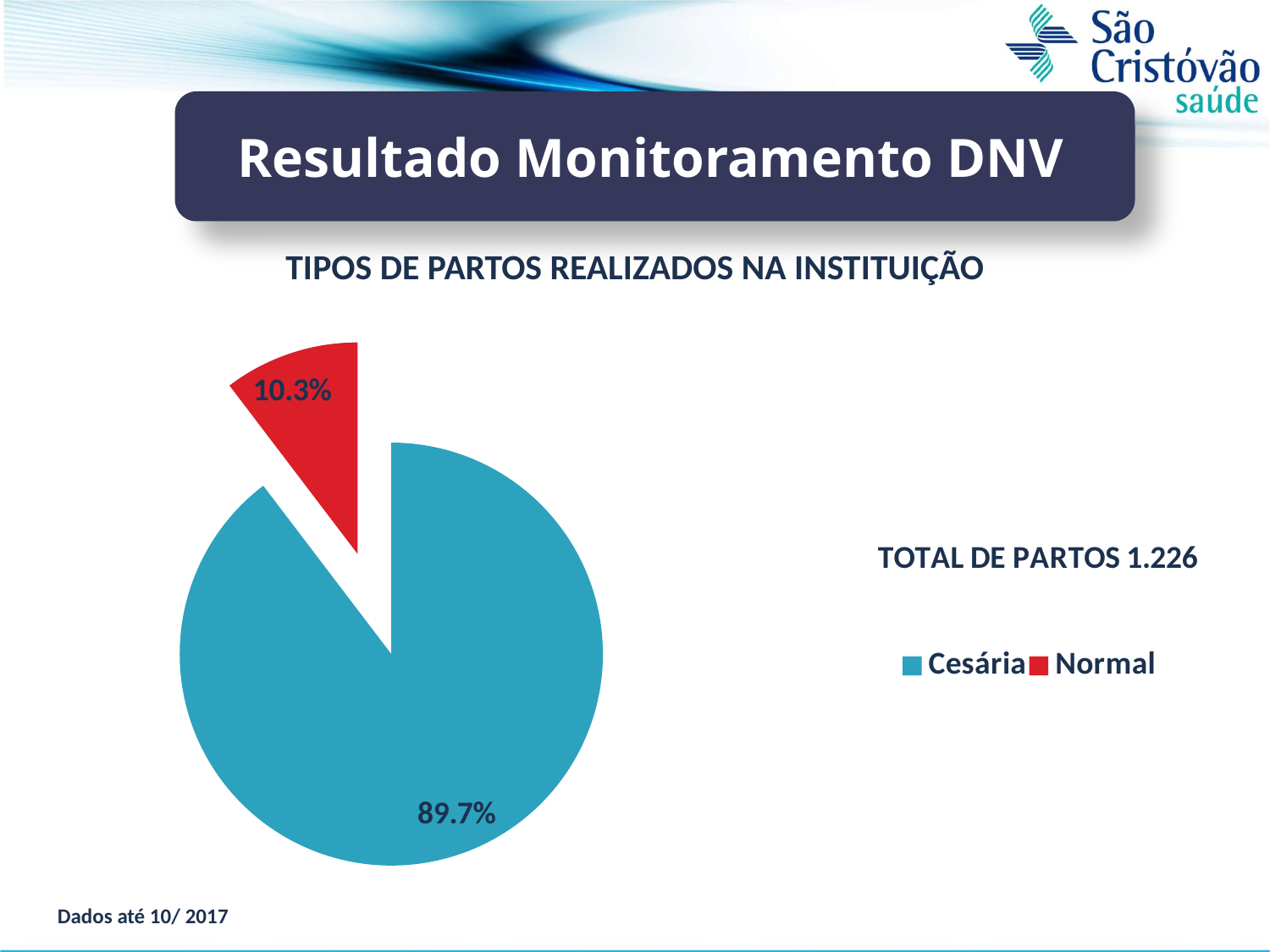
How many entries does the legend list? 2 What is the title of the chart? TIPOS DE PARTOS REALIZADOS NA INSTITUIÇÃO Which delivery type has the largest share of the pie? Cesária What kind of chart is shown on the slide? pie chart What percentage of deliveries were Cesária? 89.7% What percentage of deliveries were Normal? 10.3% Which is larger, the share for Cesária or the share for Normal? Cesária What is the difference in percentage points between the Cesária and Normal shares? 79.4 How many slices does the pie chart have? 2 Which delivery type has the smallest share of the pie? Normal What colour is the Normal slice? red What is the total number of deliveries stated next to the chart? 1.226